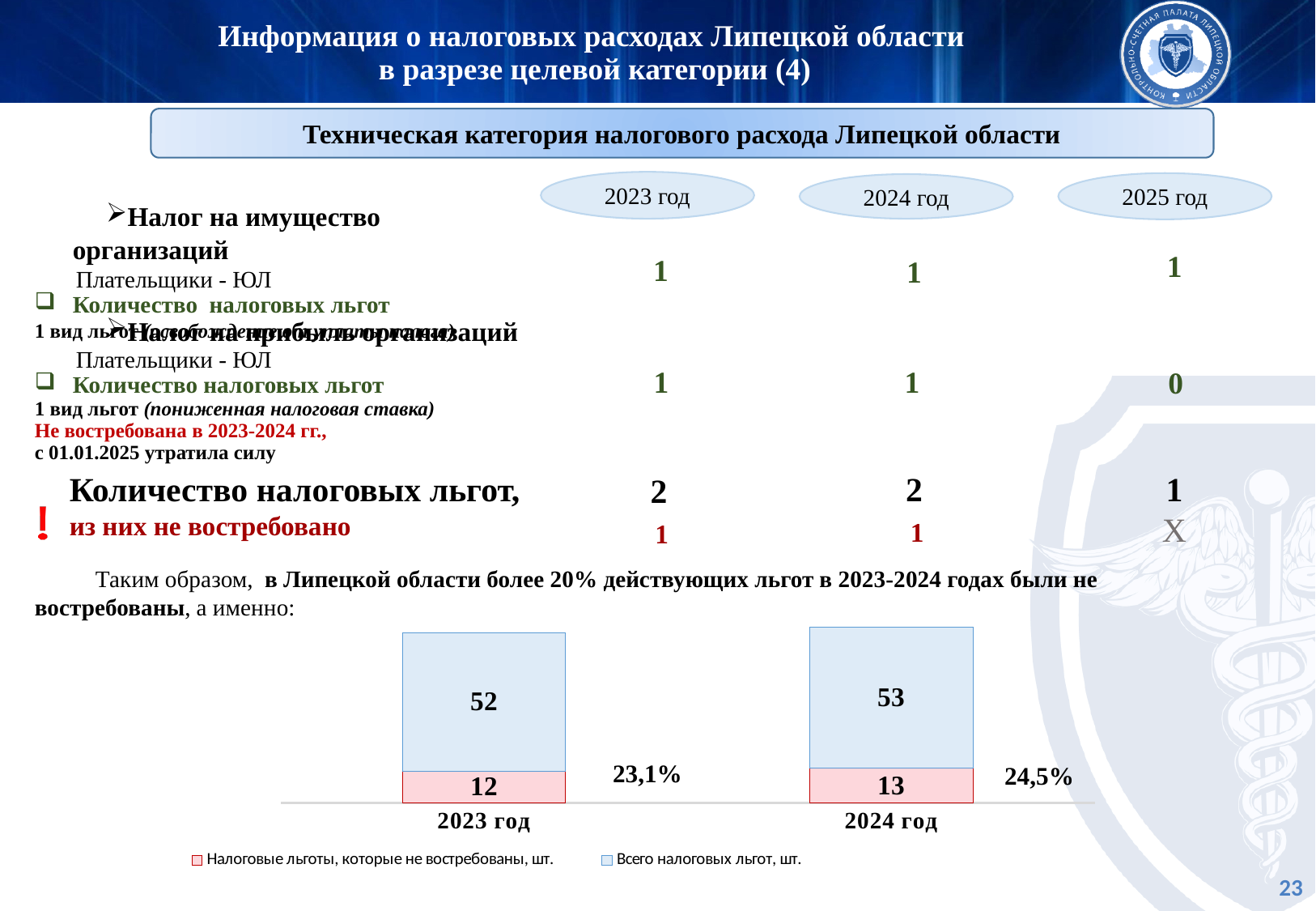
In the bar chart at the bottom of the slide, what is the value of "Налоговые льготы, которые не востребованы, шт." for 2023 год? 12 In the bar chart at the bottom of the slide, what is the value of "Налоговые льготы, которые не востребованы, шт." for 2024 год? 13 In the bar chart at the bottom of the slide, what percentage is shown next to the 2024 год bar? 24,5% In the bar chart at the bottom of the slide, what is the difference between "Всего налоговых льгот, шт." in 2024 год and in 2023 год? 1 In the bar chart at the bottom of the slide, does the value of "Налоговые льготы, которые не востребованы, шт." rise or fall from 2023 год to 2024 год? Rise In the bar chart at the bottom of the slide, what is the value of "Всего налоговых льгот, шт." for 2024 год? 53 In the bar chart at the bottom of the slide, which year has the larger value of "Налоговые льготы, которые не востребованы, шт.": 2023 год or 2024 год? 2024 год In the bar chart at the bottom of the slide, what percentage is shown next to the 2023 год bar? 23,1% What kind of chart is shown at the bottom of the slide? Stacked bar chart How many years (categories) are shown in the bar chart at the bottom of the slide? 2 In the bar chart at the bottom of the slide, what is the value of "Всего налоговых льгот, шт." for 2023 год? 52 How many series does the legend of the bar chart at the bottom of the slide list? 2